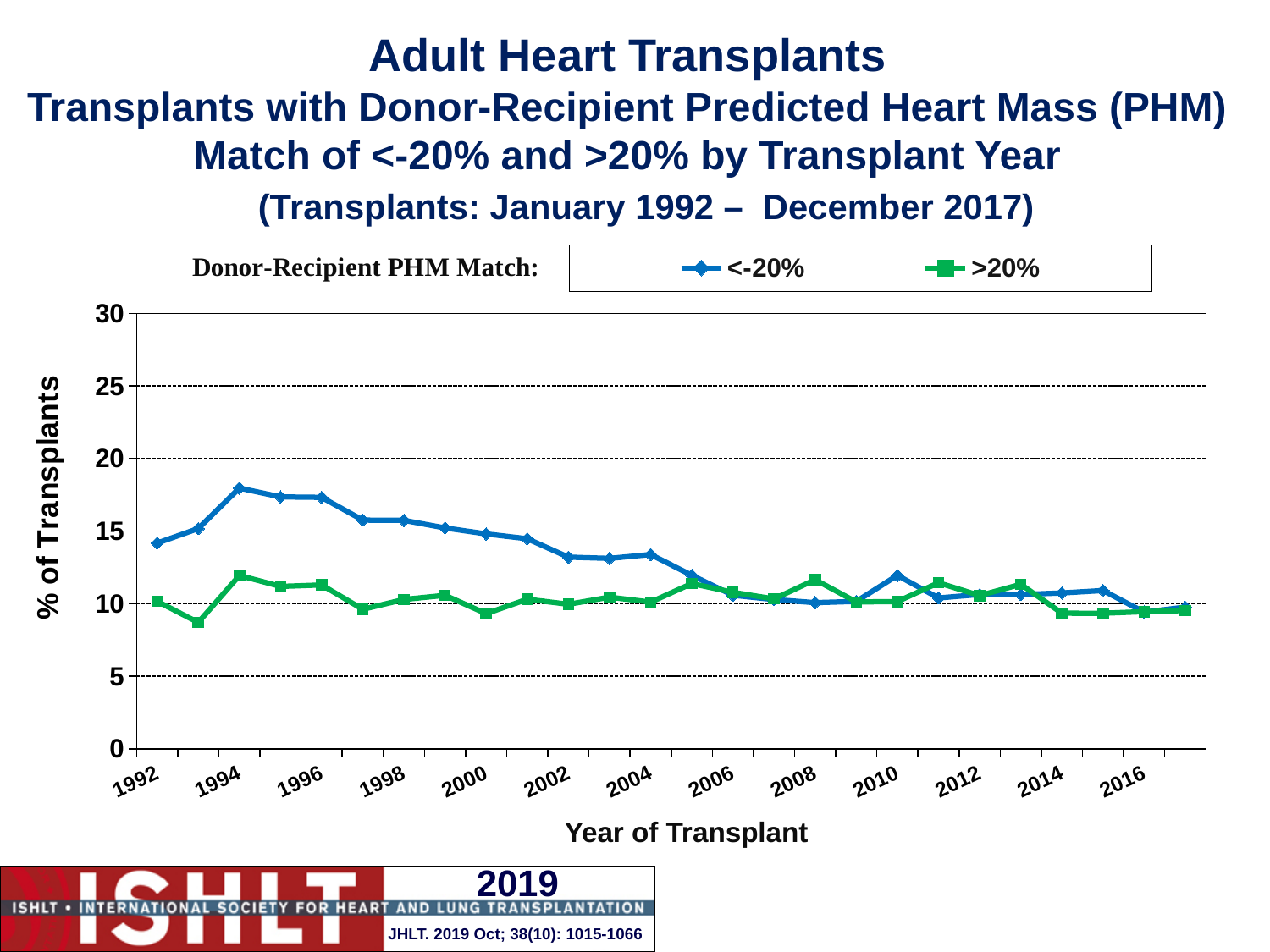
What are the two series named in the legend? <-20% and >20% In which year does the <-20% series reach its highest value? 1994 How many series does the legend list? 2 Is the value for the >20% series in 1994 greater or less than 15? less How many year labels are printed on the x axis? 13 Is the value for the <-20% series in 1994 greater or less than 15? greater Is the value for the >20% series in 1993 greater or less than 10? less In 1994, which series has the larger value, <-20% or >20%? <-20% Does the <-20% series generally rise or fall from 1992 to 2017? fall What is the label of the y axis? % of Transplants What kind of chart is shown on the slide? line chart